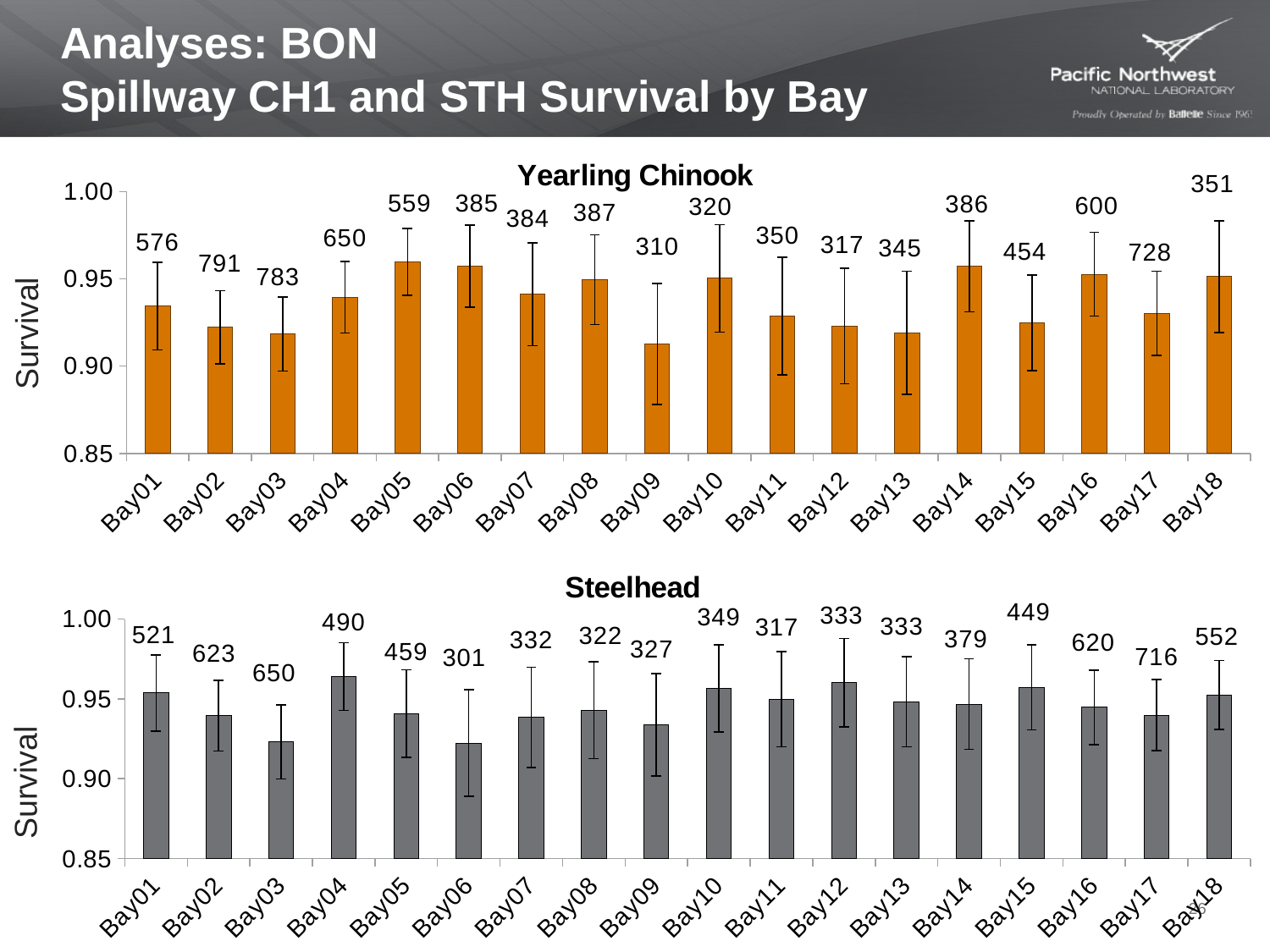
On the Steelhead chart, which bay has the higher survival bar, Bay04 or Bay06? Bay04 On the Yearling Chinook chart, which bay has the largest number printed above its bar? Bay02 How many bays are shown on the Steelhead chart? 18 On the Steelhead chart, is the survival value for Bay04 greater or less than 0.95? greater What is the title of the top chart on the slide? Yearling Chinook On the Yearling Chinook chart, which bay has the higher survival bar, Bay05 or Bay09? Bay05 On the Yearling Chinook chart, what number is printed above the bar for Bay05? 559 On the Steelhead chart, what number is printed above the bar for Bay15? 449 On the Steelhead chart, which bay has the smallest number printed above its bar? Bay06 What kind of chart is the Yearling Chinook chart? bar chart On the Yearling Chinook chart, is the survival value for Bay09 greater or less than 0.95? less What is the y-axis label on the Steelhead chart? Survival